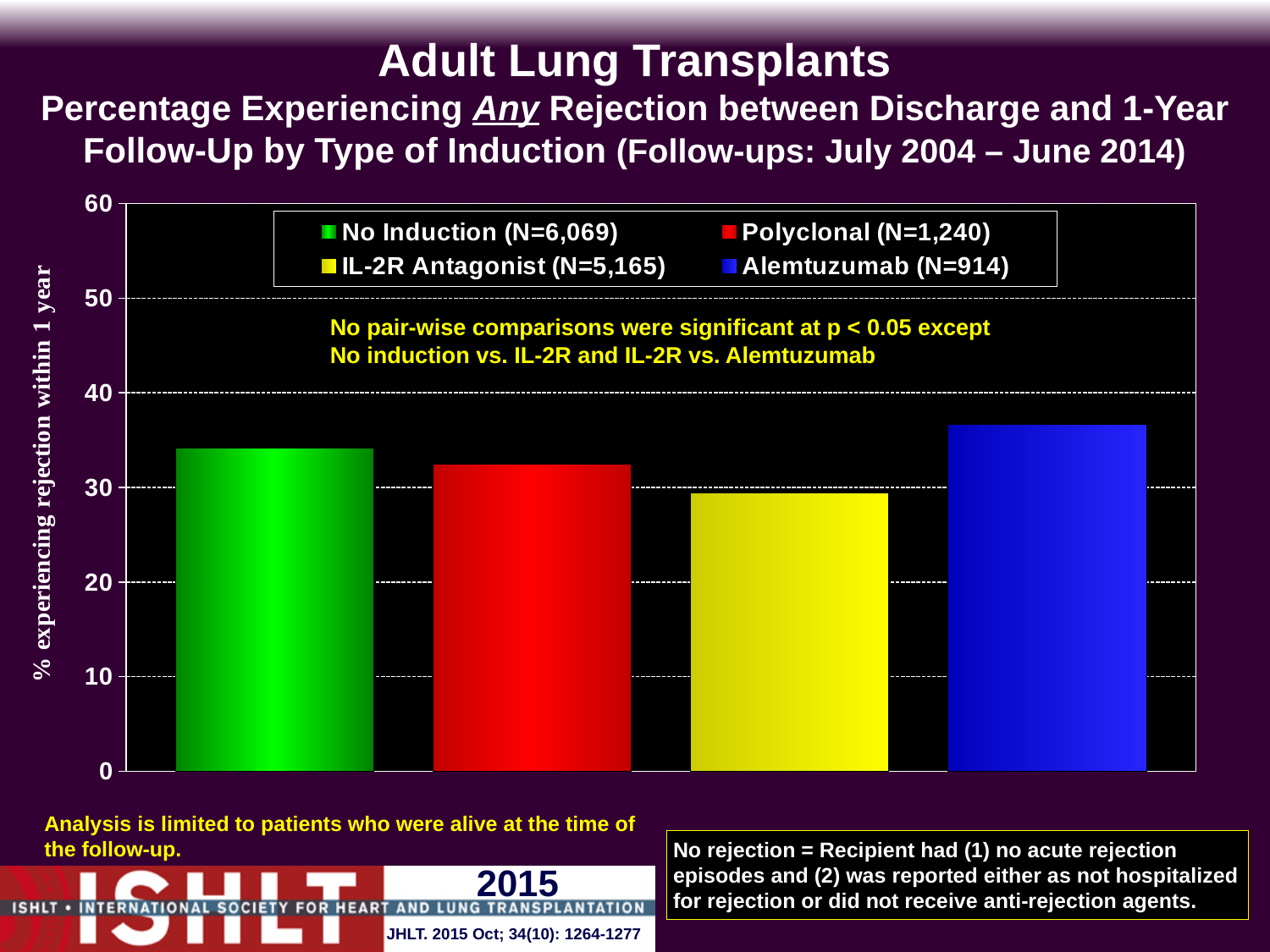
Is the value for No Induction greater or less than 30? greater How many induction types does the legend list? 4 Is the value for Polyclonal greater or less than 30? greater Is the value for Alemtuzumab greater or less than 40? less What colour is the bar for Alemtuzumab? blue Which has a higher percentage experiencing rejection: No Induction or Polyclonal? No Induction How many bars are plotted in the chart? 4 Which induction type has the highest percentage experiencing rejection within 1 year? Alemtuzumab (N=914) What kind of chart is shown on the slide? bar chart Which has a higher percentage experiencing rejection: Alemtuzumab or IL-2R Antagonist? Alemtuzumab Which induction type has the lowest percentage experiencing rejection within 1 year? IL-2R Antagonist (N=5,165) What is the sample size (N) shown in the legend for Polyclonal induction? 1,240